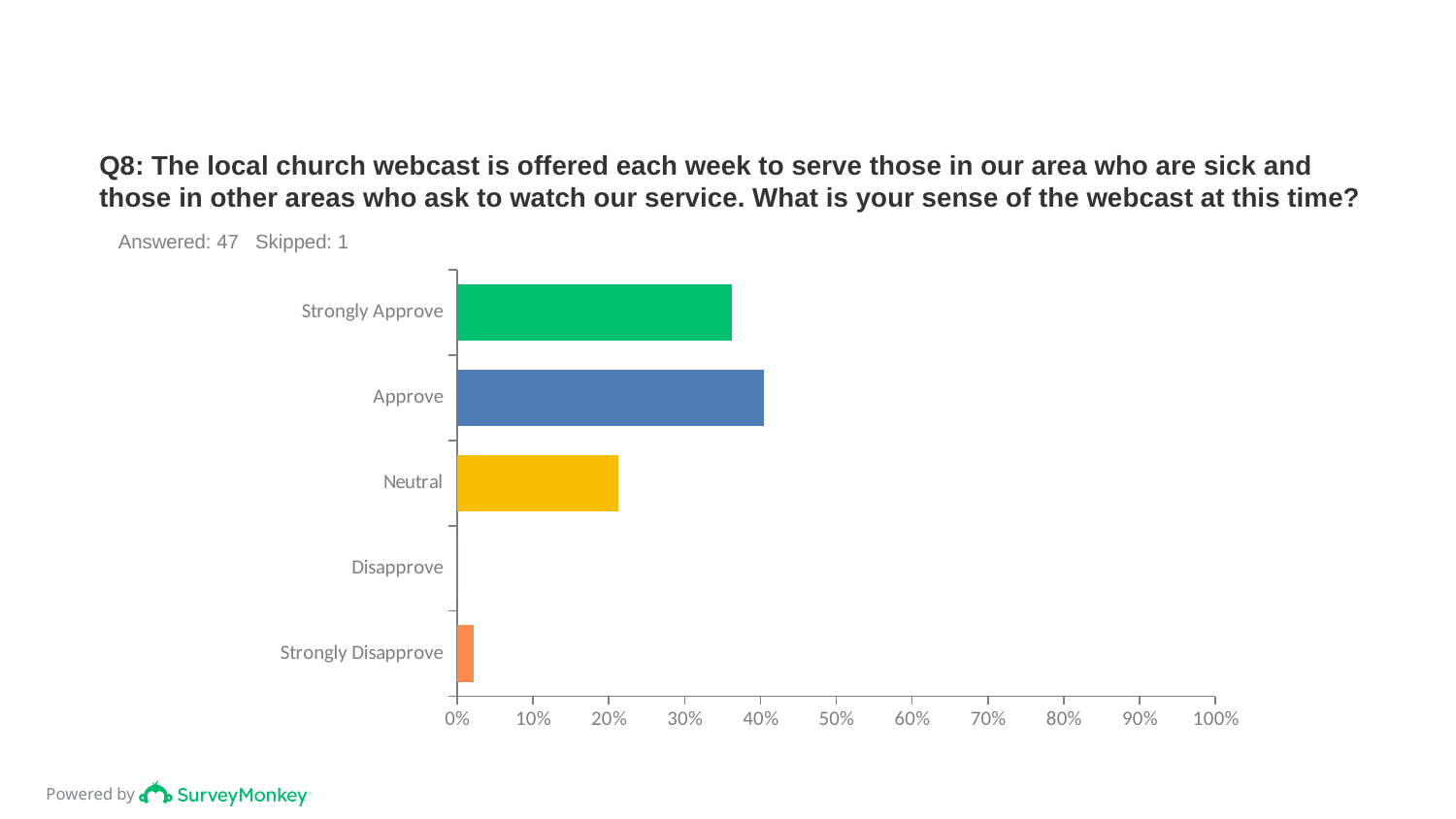
Which is larger, the value for Strongly Approve or the value for Neutral? Strongly Approve What is the value for Disapprove? 0% Is the value for Strongly Approve greater or less than 30%? greater Is the value for Neutral greater or less than 30%? less Which is larger, the value for Approve or the value for Strongly Approve? Approve How many response categories are shown on the chart? 5 What kind of chart is shown on the slide? bar chart Which response category has the lowest value? Disapprove How many respondents answered this question according to the slide? 47 Is the value for Neutral greater or less than 10%? greater Which response category has the highest value? Approve